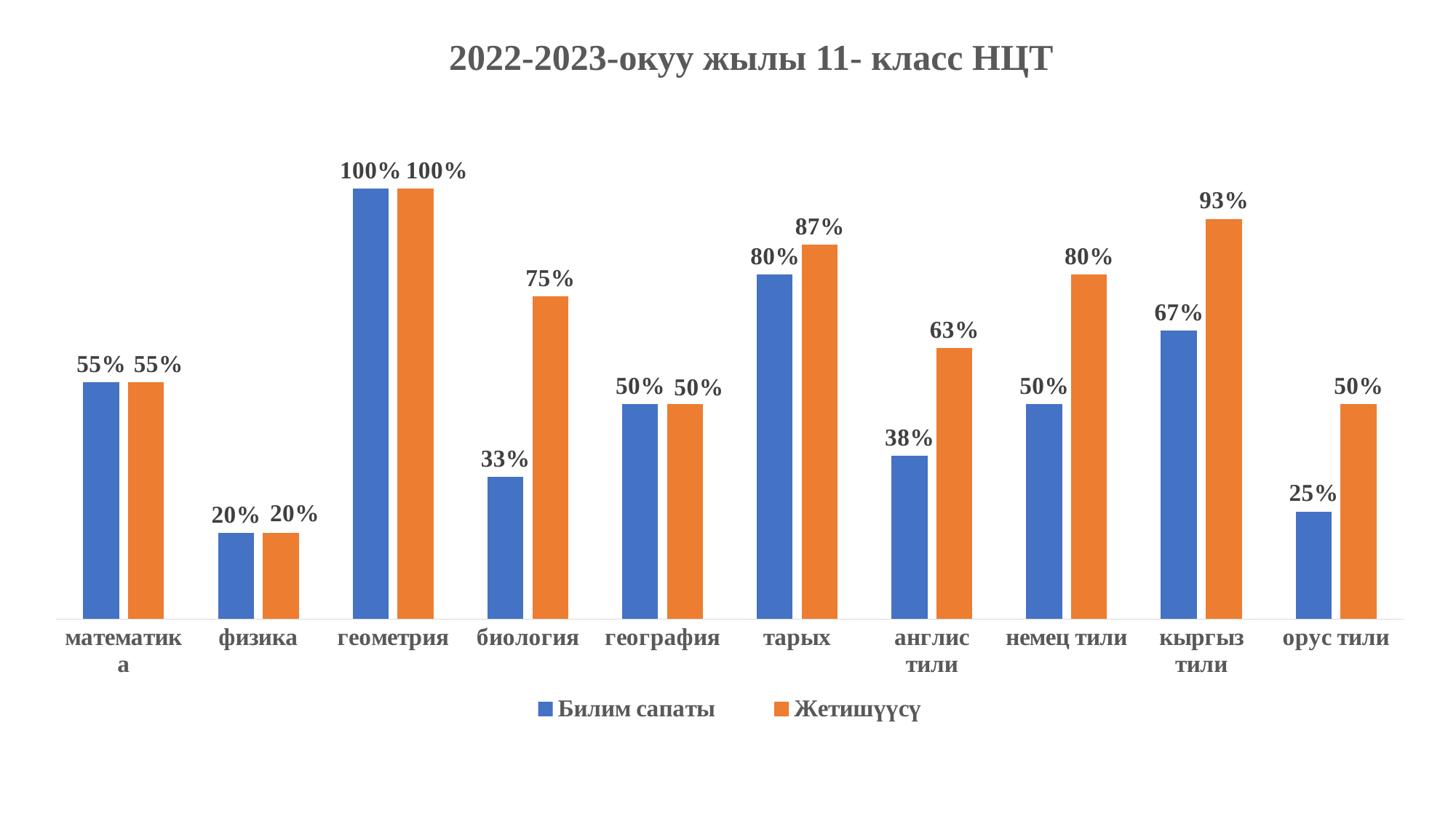
What is the title of the chart? 2022-2023-окуу жылы 11- класс НЦТ What kind of chart is shown on the slide? bar chart Which category has the lowest Билим сапаты value? физика How many categories are shown on the x axis? 10 Which is larger for немец тили: Билим сапаты or Жетишүүсү? Жетишүүсү How many series does the legend list? 2 What is the value of Билим сапаты for тарых? 80% What is the value of Жетишүүсү for биология? 75% What is the value of Билим сапаты for орус тили? 25% What is the difference between Жетишүүсү and Билим сапаты for англис тили? 25% Which category has the highest Жетишүүсү value? геометрия What is the value of Жетишүүсү for кыргыз тили? 93%